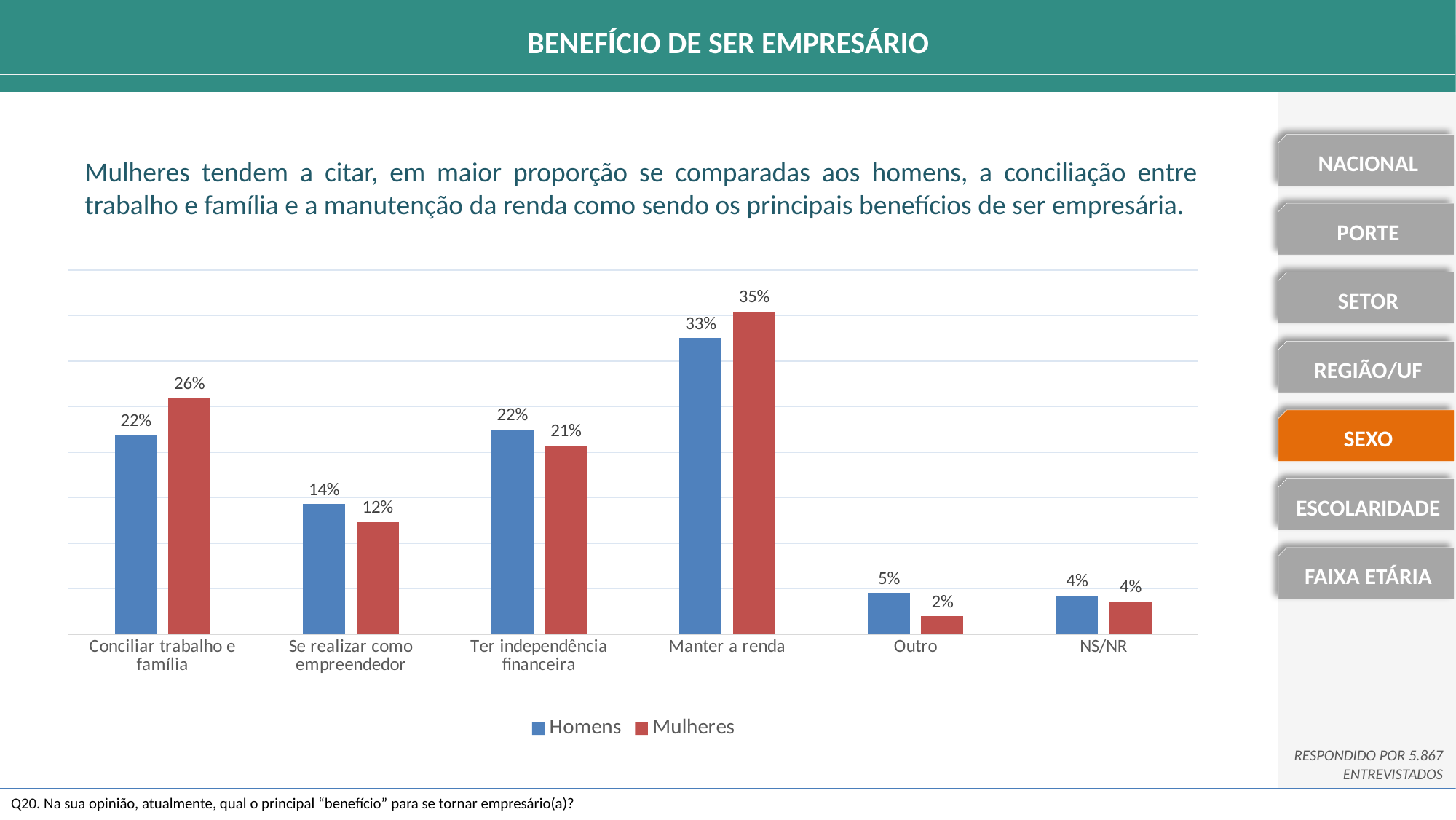
How many series does the legend list? 2 Which is larger for 'Ter independência financeira': Homens or Mulheres? Homens Which category has the highest value for Mulheres? Manter a renda What is the difference between the Homens and Mulheres values for 'Se realizar como empreendedor'? 2% What is the value for Mulheres in the 'Conciliar trabalho e família' category? 26% Which category has the lowest value for Homens? NS/NR How many categories are shown on the x axis? 6 What is the value for Homens in the 'Manter a renda' category? 33% Which colour represents the Mulheres series? Red What kind of chart is shown on the slide? Bar chart What is the difference between the Mulheres and Homens values for 'Conciliar trabalho e família'? 4% What is the value for Mulheres in the 'Outro' category? 2%